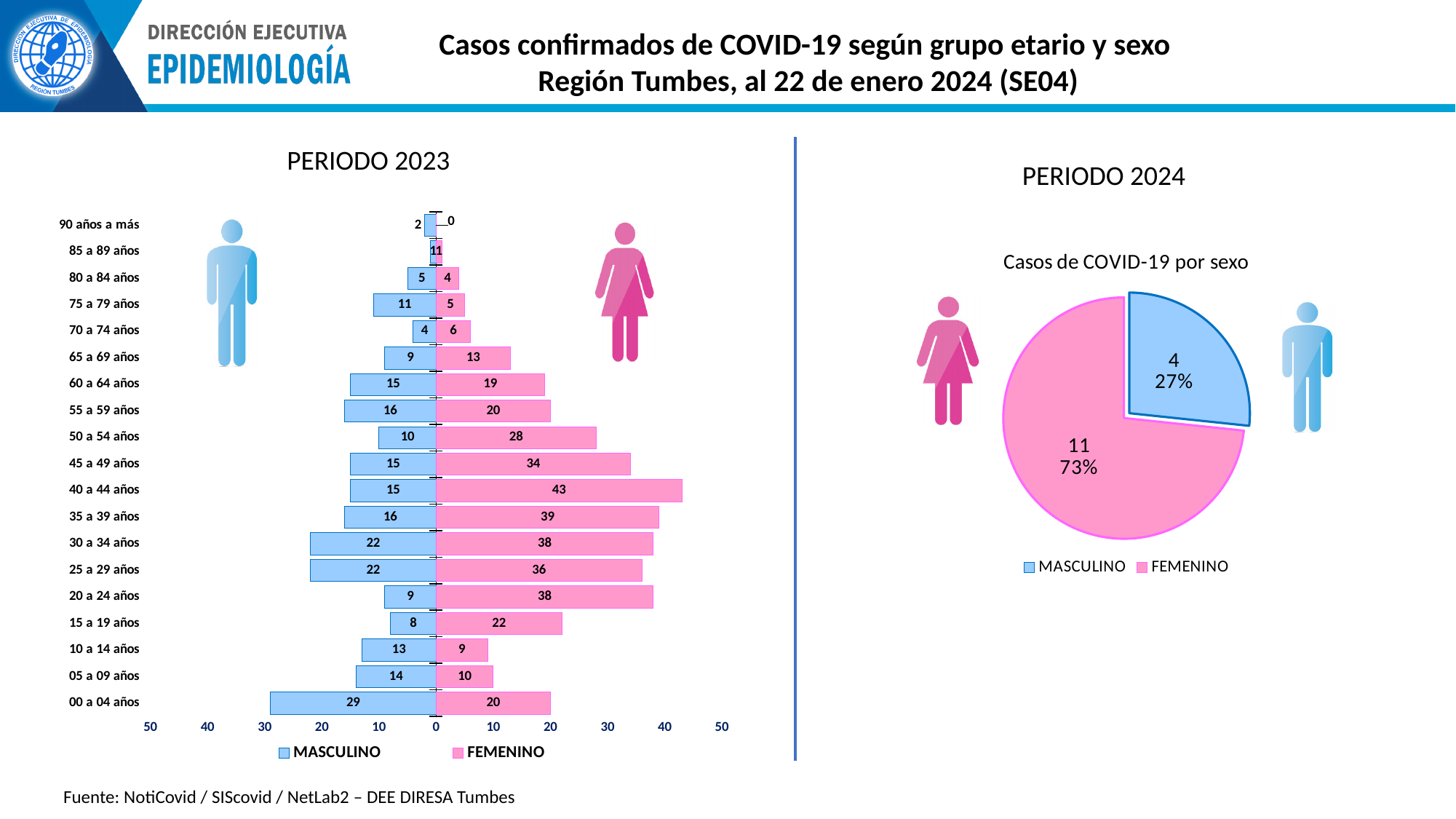
In the PERIODO 2023 chart, how many age groups are shown? 19 What is the title of the pie chart on the right side of the slide? Casos de COVID-19 por sexo In the PERIODO 2023 chart, how many series does the legend list? 2 In the PERIODO 2023 chart, which age group has the highest FEMENINO value? 40 a 44 años In the PERIODO 2023 chart, which age group has the highest MASCULINO value? 00 a 04 años In the PERIODO 2024 pie chart, how many MASCULINO cases are shown? 4 What kind of chart is the PERIODO 2023 chart? Bar chart In the PERIODO 2023 chart, which is larger for 75 a 79 años, the MASCULINO or the FEMENINO value? MASCULINO In the PERIODO 2023 chart, what is the MASCULINO value for 00 a 04 años? 29 In the PERIODO 2024 pie chart, what share of cases is FEMENINO? 73% In the PERIODO 2023 chart, what is the FEMENINO value for 40 a 44 años? 43 In the PERIODO 2023 chart, what is the difference between the FEMENINO and MASCULINO values for 20 a 24 años? 29